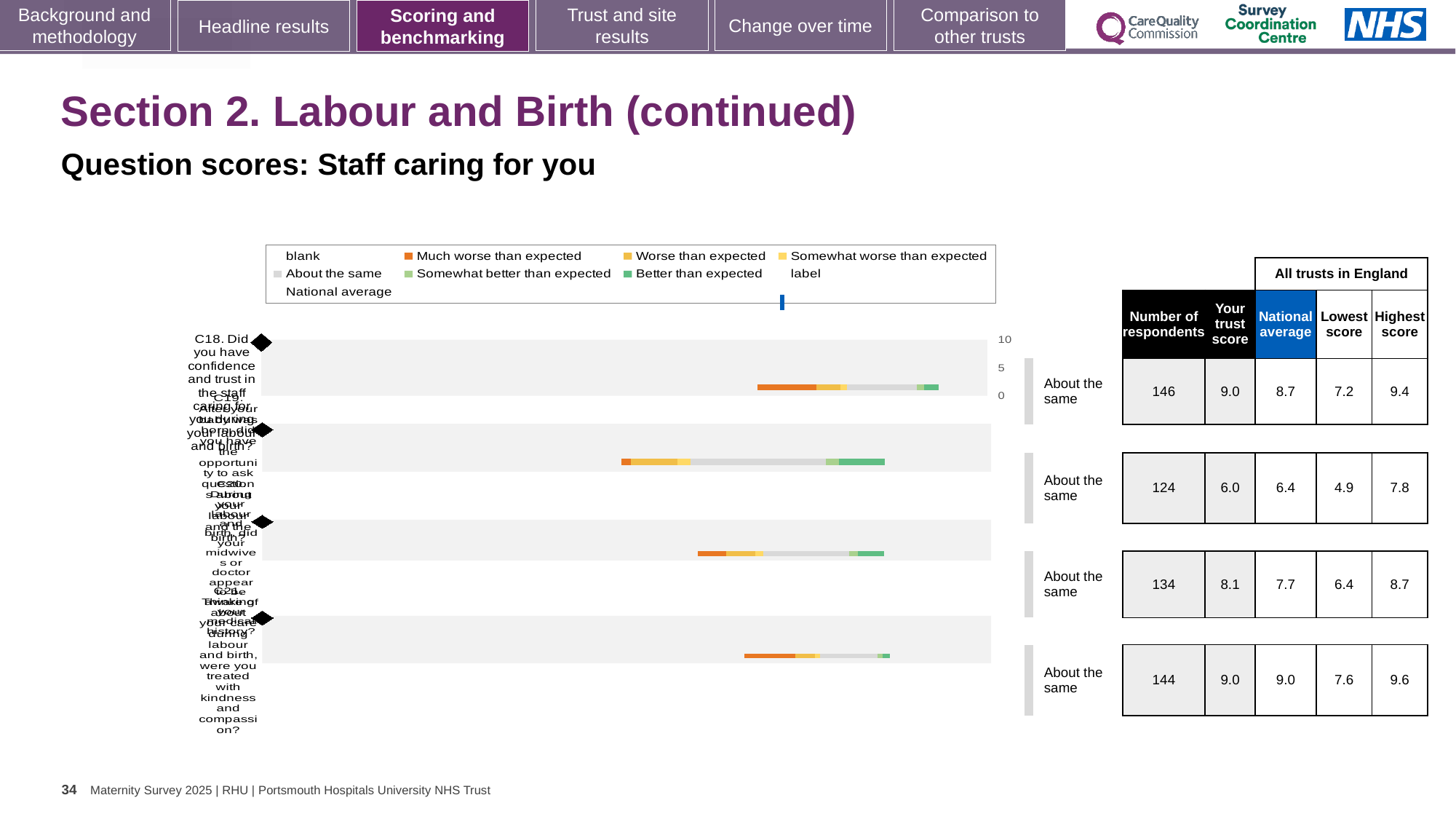
What kind of chart is shown on the slide? bar chart What is the lowest score among all trusts in England for the second question row (C19)? 4.9 What benchmark category is shown for all four questions in the chart? About the same What is the difference between the trust score and the national average for question C18? 0.3 What is the highest score among all trusts in England for the fourth question row (C21)? 9.6 What is the national average for the second question row (C19)? 6.4 What is the subtitle describing the question scores shown in the chart? Question scores: Staff caring for you Which question row has the lowest 'Your trust score'? C19 (second row), 6.0 What is the 'Your trust score' for question C18 (confidence and trust in the staff caring for you)? 9.0 For the third question row (C20), which is larger: the trust score or the national average? the trust score (8.1) How many questions (bars) are plotted in the chart? 4 What is the number of respondents for question C18? 146